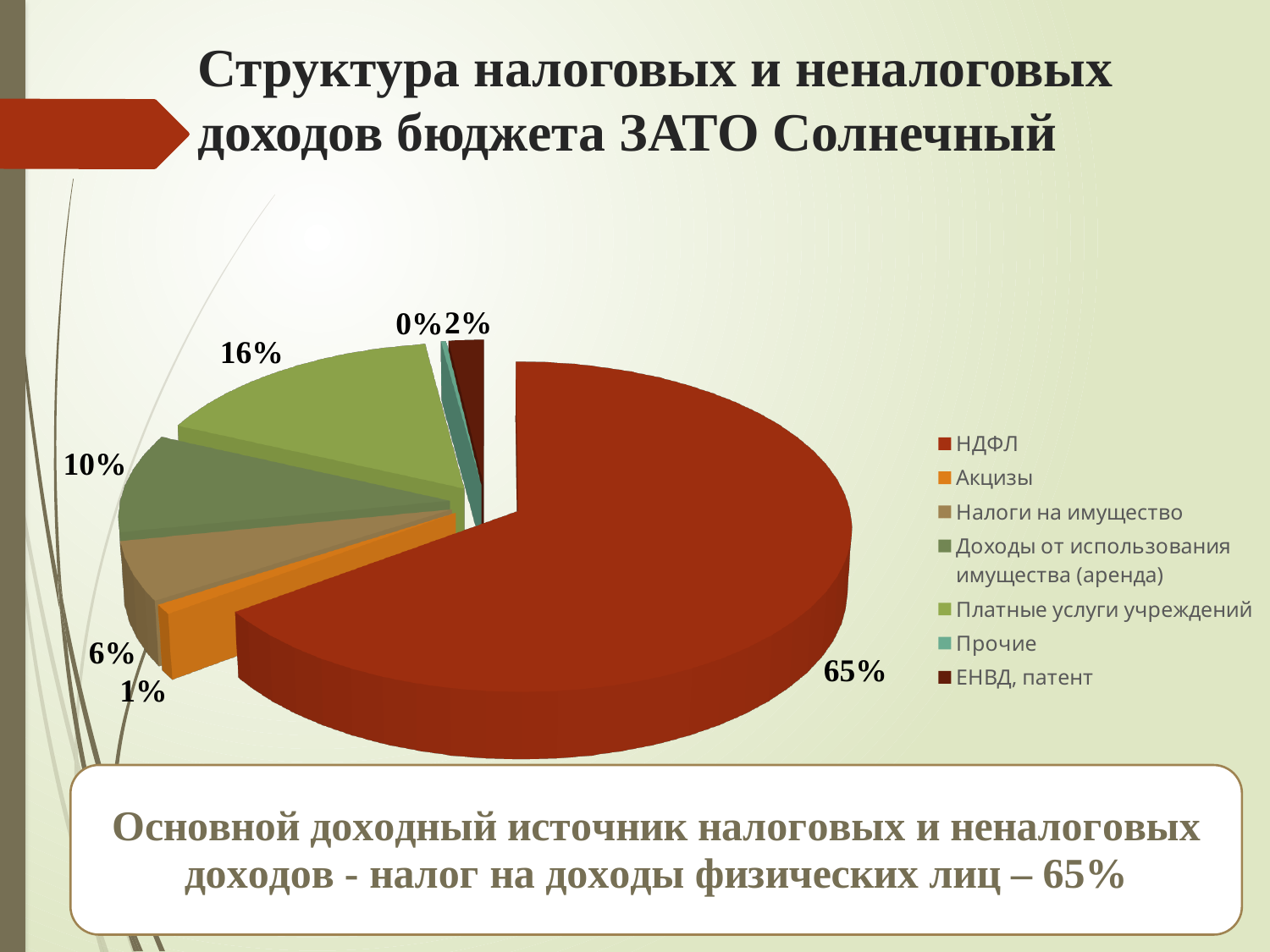
What is the value shown for Прочие? 0% How many categories does the legend of the pie chart list? 7 What is the difference between the shares of НДФЛ and Платные услуги учреждений? 49% What kind of chart is shown on the slide? pie chart What is the value shown for ЕНВД, патент? 2% What is the value shown for Доходы от использования имущества (аренда)? 10% Which category has the largest share of the pie? НДФЛ What share of the pie does НДФЛ have? 65% Which category has the smallest share of the pie? Прочие What is the title of the slide containing the pie chart? Структура налоговых и неналоговых доходов бюджета ЗАТО Солнечный What is the value shown for Платные услуги учреждений? 16% Which is larger: the share of Платные услуги учреждений or the share of Доходы от использования имущества (аренда)? Платные услуги учреждений